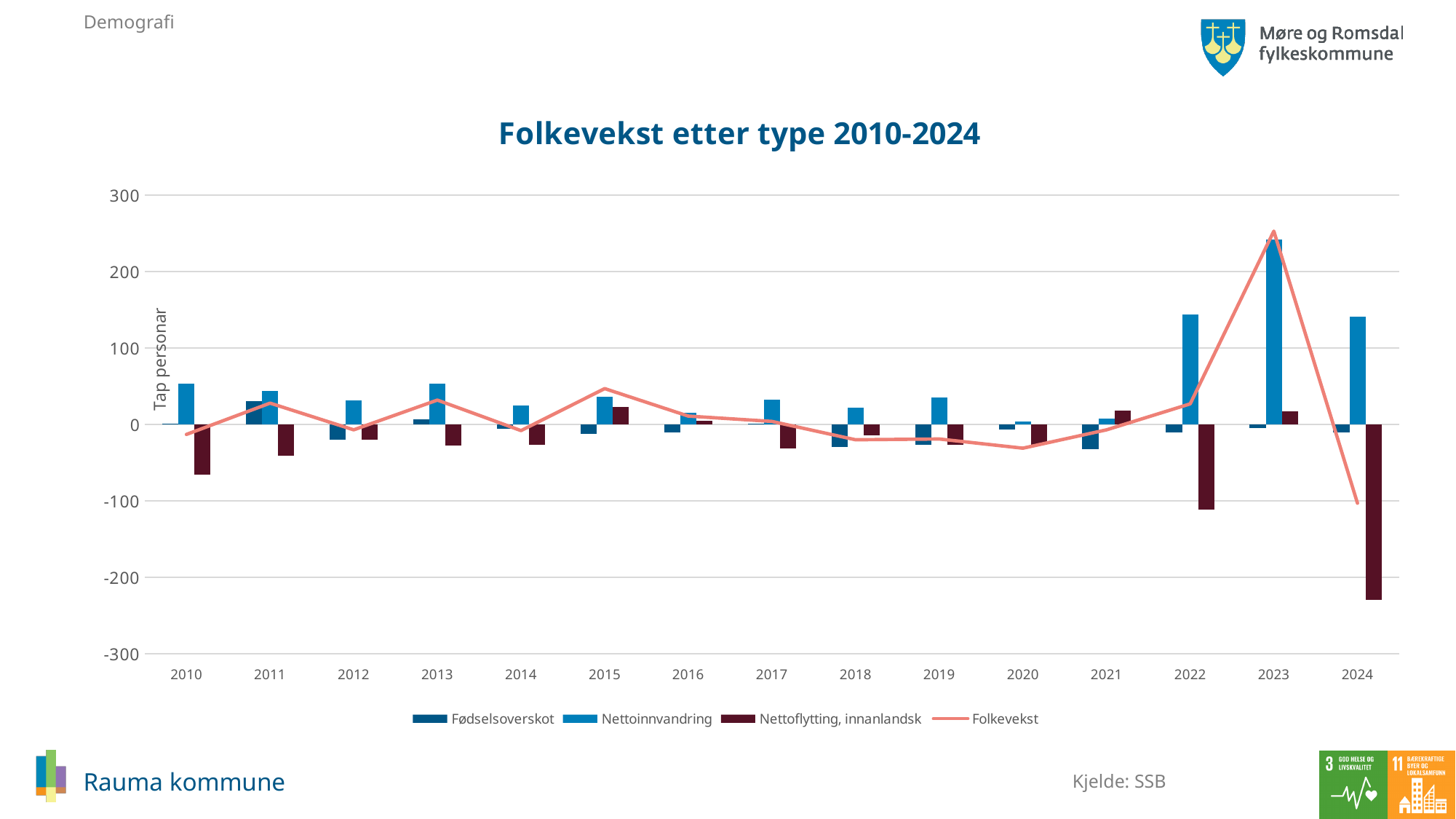
Is the value for Nettoinnvandring in 2023 greater or less than 200? greater Which series is drawn as a line rather than bars? Folkevekst Is the value for Nettoinnvandring in 2022 greater or less than 100? greater How many years are shown on the x axis of the chart? 15 What kind of chart is shown on the slide? A combined bar and line chart In which year is the Nettoinnvandring bar highest? 2023 Does the Folkevekst line rise or fall from 2023 to 2024? Fall Is the value for Nettoflytting, innanlandsk in 2024 greater or less than -200? less In which year does the Folkevekst line reach its highest point? 2023 How many series does the legend list? 4 Which is larger, the Folkevekst value in 2023 or in 2015? 2023 In which year is the Nettoflytting, innanlandsk bar lowest? 2024